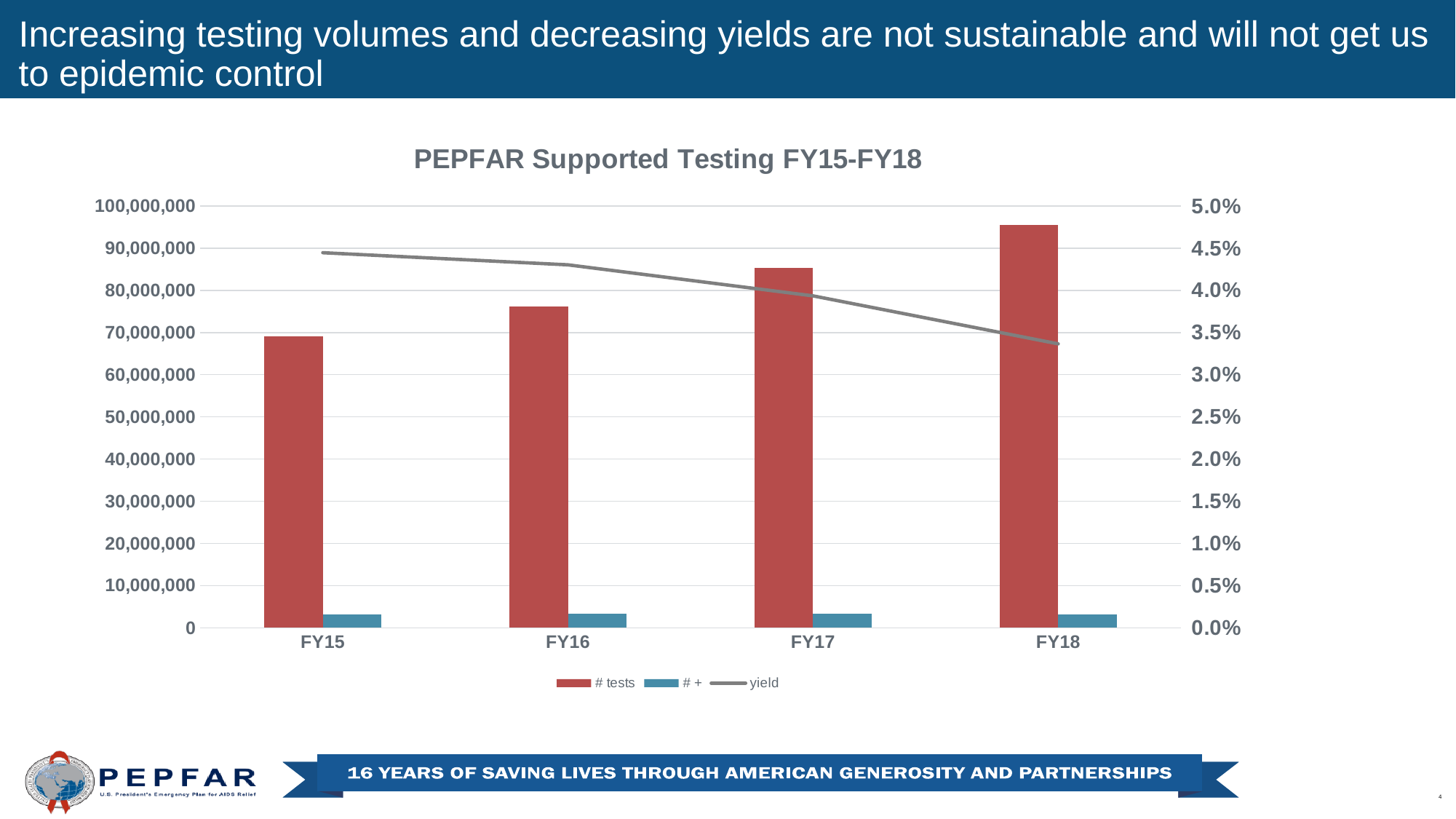
Do the # tests values rise or fall from FY15 to FY18? Rise Does the yield line rise or fall from FY15 to FY18? Fall Which is larger, the # tests value for FY17 or for FY16? FY17 Is the # tests value for FY18 greater or less than 90,000,000? greater What kind of chart is shown on the slide? Bar chart with a line How many series does the legend list? 3 What is the title of the chart? PEPFAR Supported Testing FY15-FY18 Which fiscal year has the highest number of tests (# tests)? FY18 Is the yield for FY18 greater or less than 3.5%? less How many fiscal years are shown on the x axis? 4 Which fiscal year has the lowest number of tests (# tests)? FY15